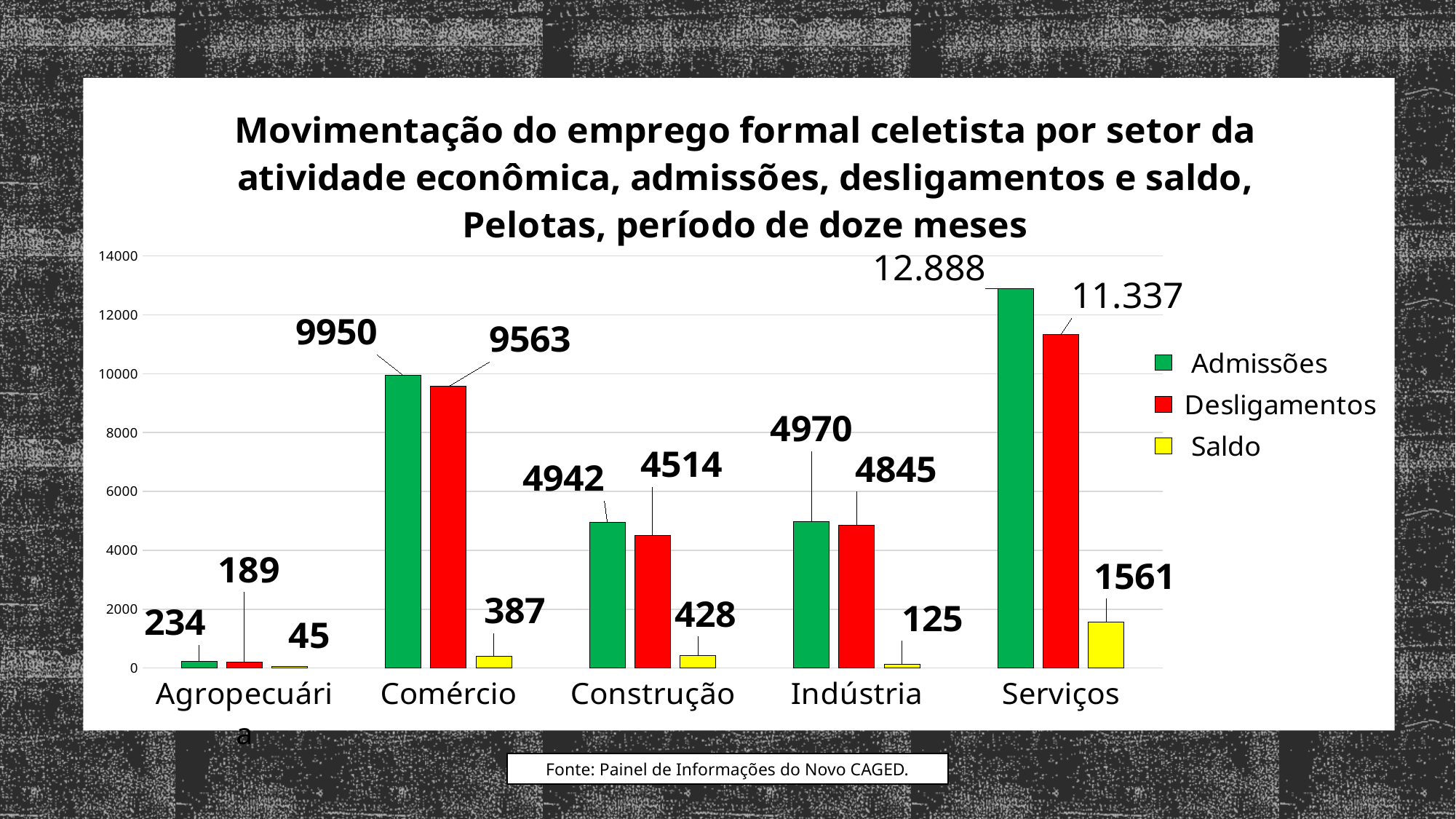
What is the value of Desligamentos for Agropecuária? 189 How many series does the legend list? 3 What is the difference between Admissões and Desligamentos for Construção? 428 Which is larger: Desligamentos for Comércio or Desligamentos for Serviços? Desligamentos for Serviços Which sector has the lowest Saldo value? Agropecuária What kind of chart is shown on the slide? Bar chart Which colour represents the Saldo series in the legend? Yellow What is the value of Desligamentos for Serviços? 11.337 What is the value of Admissões for Comércio? 9950 How many sectors are shown on the x axis? 5 What is the Saldo value for Indústria? 125 Which sector has the highest Admissões value? Serviços